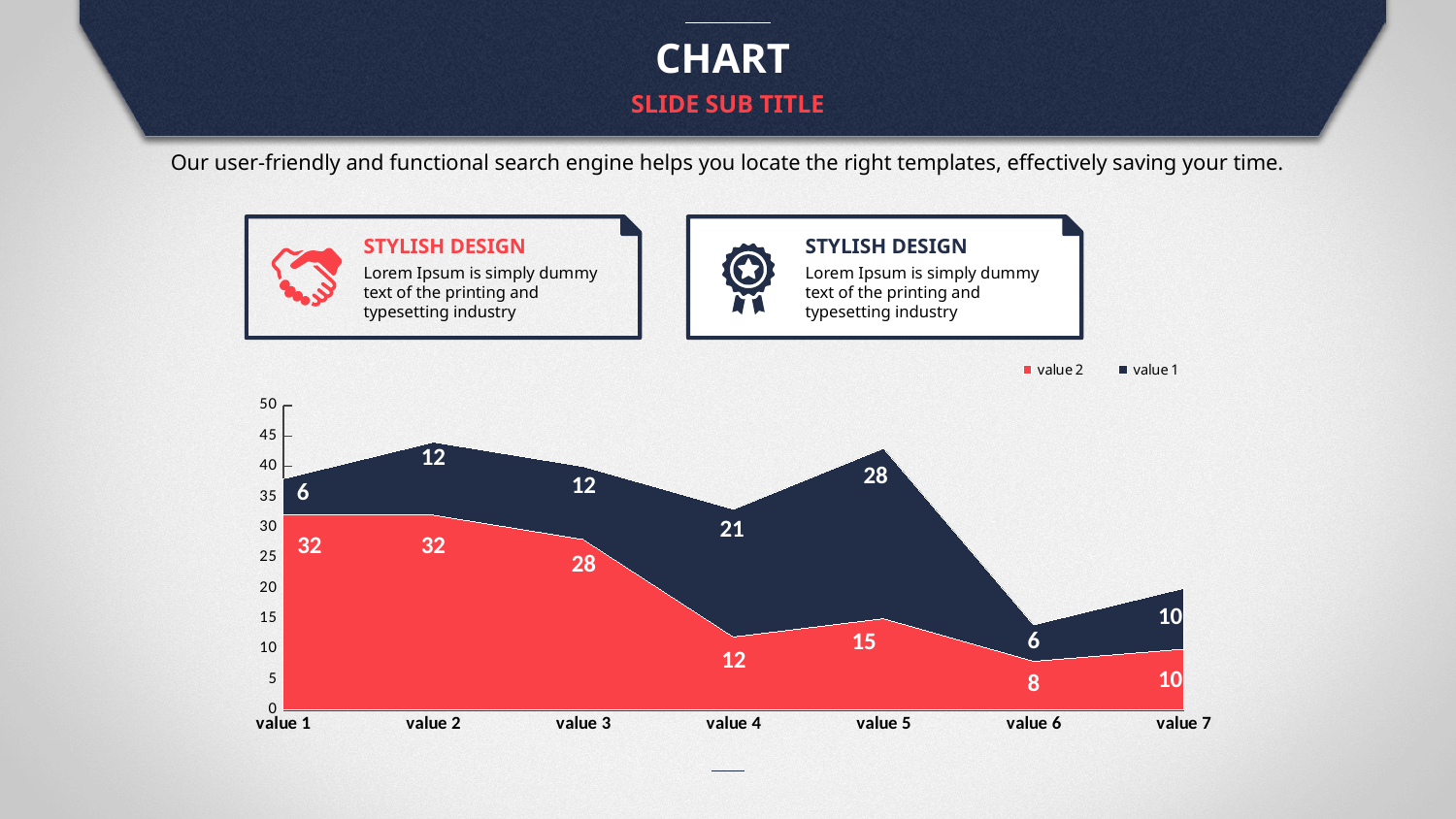
What is the combined total of the two series at 'value 6'? 14 At 'value 5', which series has the larger value, 'value 1' or 'value 2'? value 1 How many series does the legend list? 2 Which category has the lowest value for the 'value 2' series? value 6 What is the value of the 'value 2' series at 'value 3'? 28 What is the combined total of the two series at 'value 2'? 44 What kind of chart is shown on the slide? Stacked area chart What is the value of the 'value 1' series at 'value 5'? 28 How many categories are shown on the x axis? 7 Which category has the highest value for the 'value 1' series? value 5 What is the difference between the 'value 2' values at 'value 1' and 'value 4'? 20 What is the value of the 'value 1' series at 'value 4'? 21